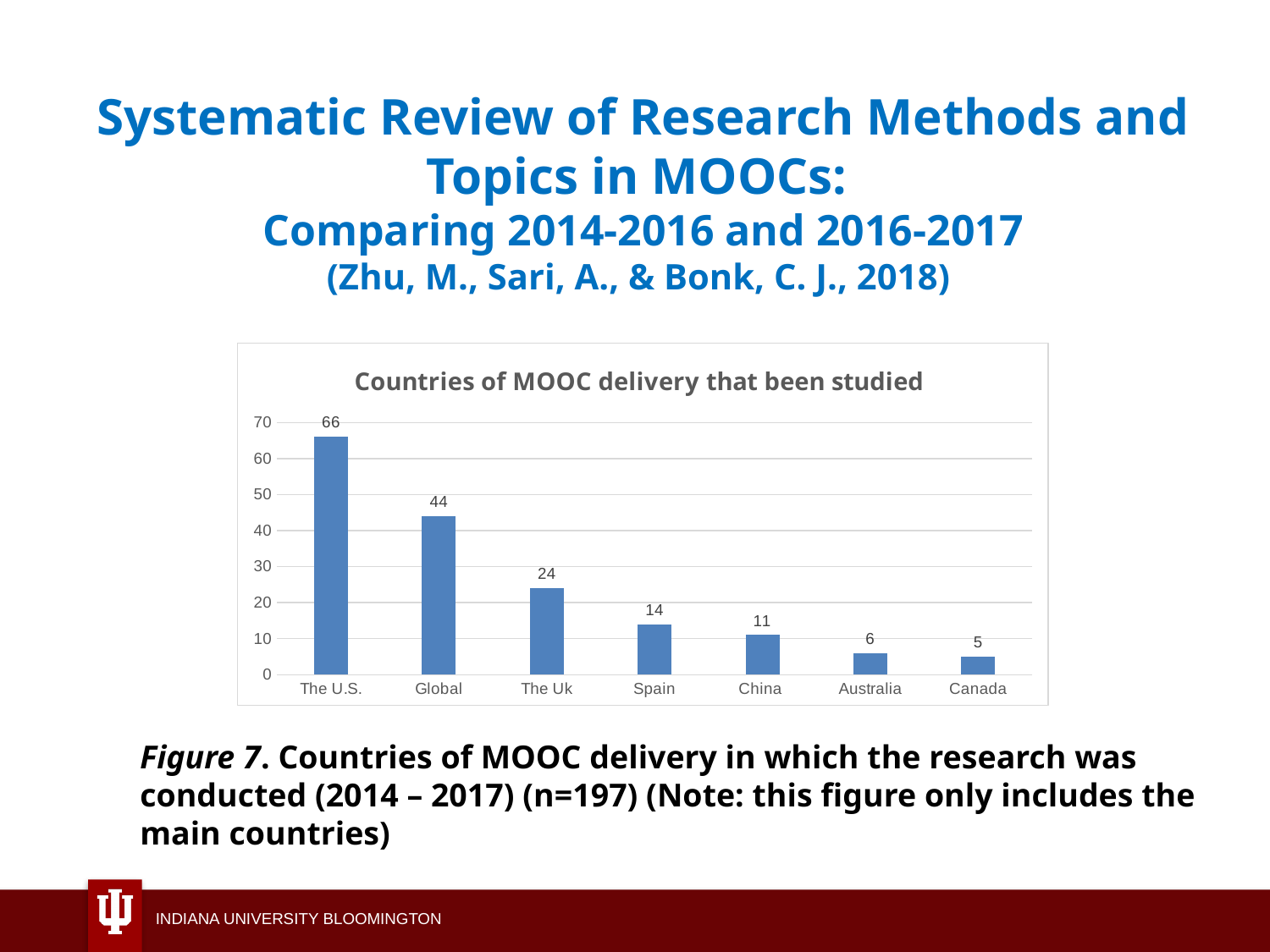
What kind of chart is shown? Bar chart What is the difference between the values for The Uk and China? 13 Which is larger, the value for China or the value for Australia? China What is the title of the chart? Countries of MOOC delivery that been studied Which country has the highest value? The U.S. Which category has the lowest value? Canada Is the value for Global greater or less than 40? greater How many categories are shown on the x axis? 7 What is the value for The U.S.? 66 What is the value for Spain? 14 What is the difference between the values for The U.S. and Global? 22 What is the value for Canada? 5